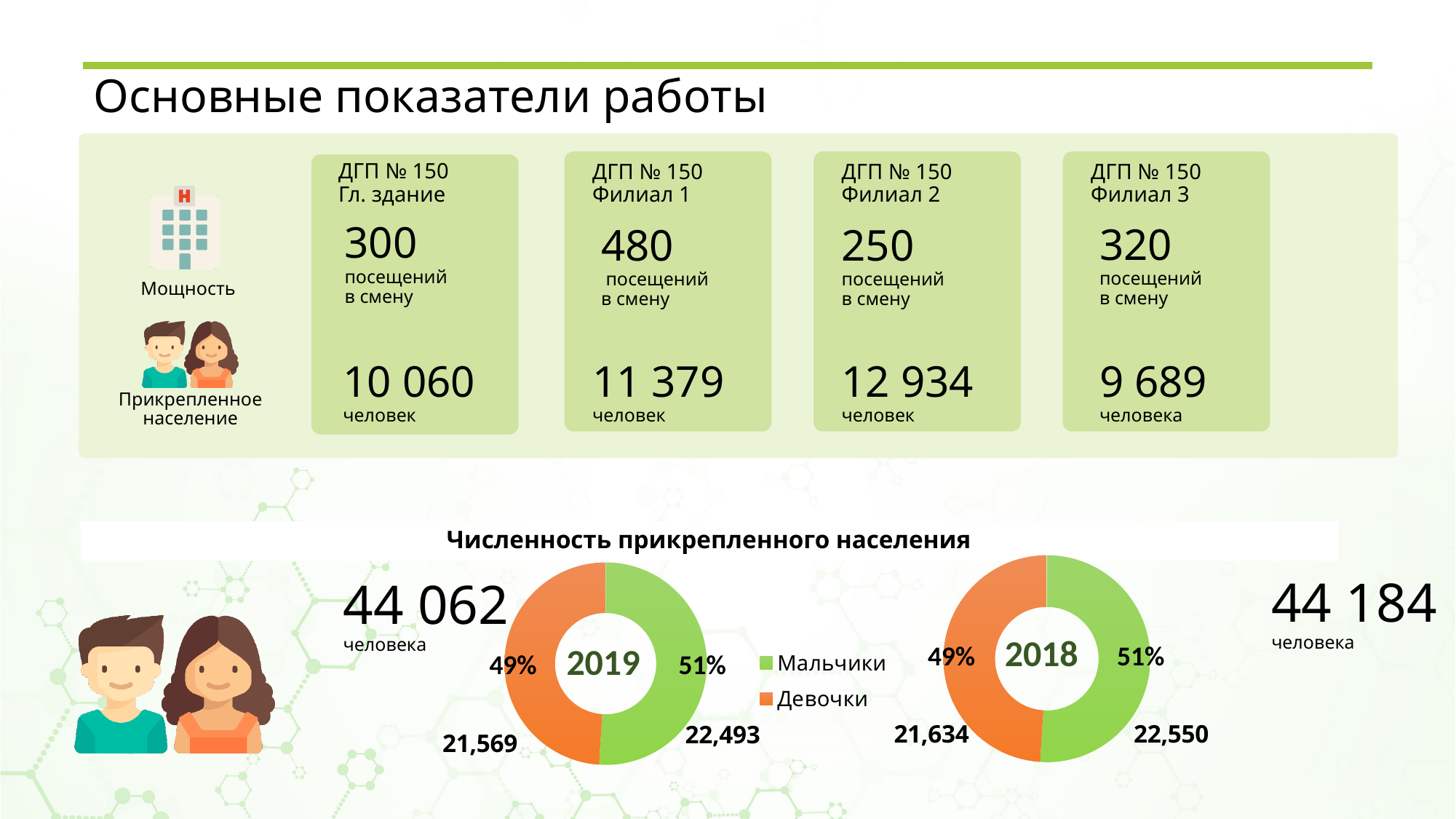
In the 2018 donut chart, what share of the total is Девочки? 49% In the 2019 donut chart, which category is the largest? Мальчики How many series does the legend list for the donut charts? 2 In the 2019 donut chart, what share of the total is Мальчики? 51% In the 2018 donut chart, which is larger, Мальчики or Девочки? Мальчики In the 2018 donut chart, what is the value for Мальчики? 22,550 In the 2019 donut chart, what is the difference between Мальчики and Девочки? 924 In the 2019 donut chart, what is the value for Мальчики? 22,493 In the 2019 donut chart, what is the value for Девочки? 21,569 What type of chart is used to show the 2019 and 2018 data? Donut (pie) chart In the 2018 donut chart, what is the value for Девочки? 21,634 In the 2018 donut chart, which category is the smallest? Девочки